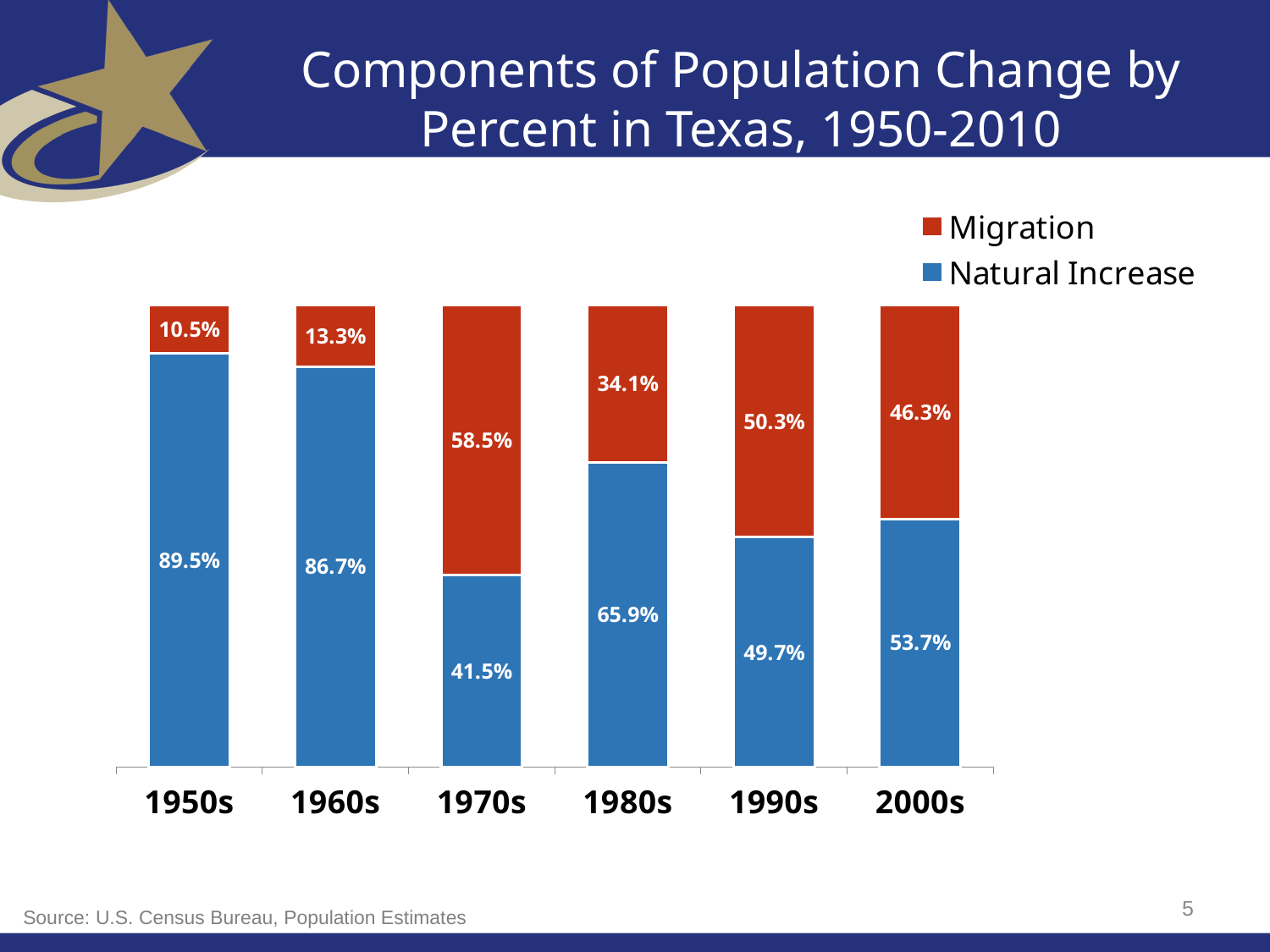
What is the difference between the Natural Increase values for the 1950s and the 1960s? 2.8% How many series does the legend list? 2 What is the Natural Increase value for the 2000s? 53.7% How many decades are shown on the x axis? 6 What kind of chart is shown on the slide? Stacked bar chart What is the Natural Increase value for the 1950s? 89.5% Which decade has the highest Migration value? 1970s Which colour represents Migration in the chart? Red What is the total of the stacked bar for the 1980s? 100% What is the Migration value for the 1970s? 58.5% Which decade has the lowest Natural Increase value? 1970s Which is larger, the Migration value for the 1990s or the Migration value for the 2000s? 1990s